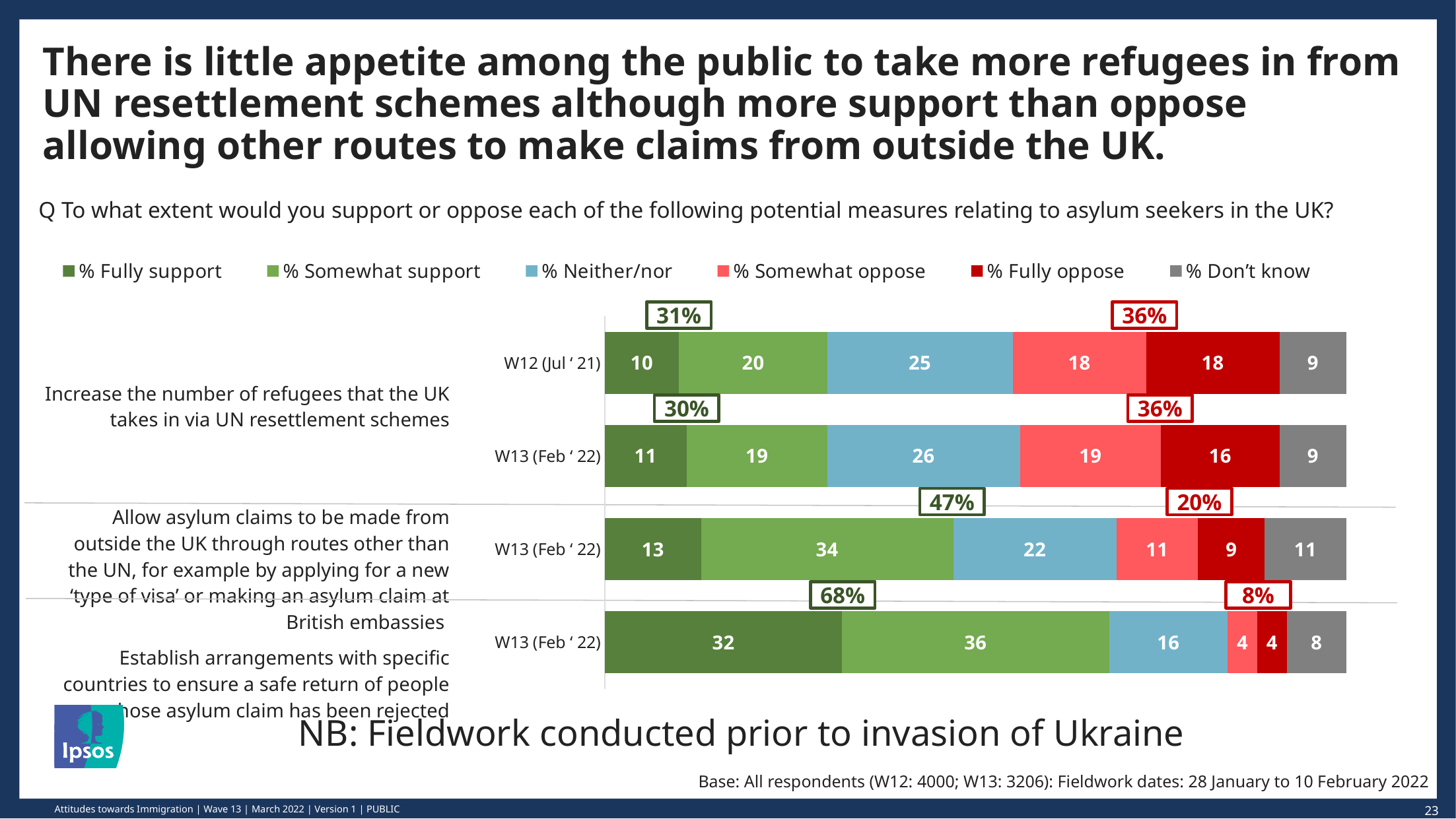
How many bars are plotted in the chart? 4 What kind of chart is shown on the slide? Stacked bar chart What is the % Neither/nor value for the W13 (Feb '22) bar on increasing the number of refugees the UK takes in via UN resettlement schemes? 26 What is the total of the stacked bar for establishing arrangements with specific countries to ensure a safe return of rejected asylum seekers? 100 What is the % Don't know value for allowing asylum claims to be made from outside the UK through routes other than the UN? 11 Which measure has the highest % Fully support value? Establish arrangements with specific countries to ensure a safe return of people whose asylum claim has been rejected What is the % Fully support value for establishing arrangements with specific countries to ensure a safe return of people whose asylum claim has been rejected? 32 How many series does the legend list? 6 What net support percentage is shown in the green box above the bar for allowing asylum claims to be made from outside the UK through routes other than the UN? 47% Which has the larger % Somewhat support value: allowing asylum claims from outside the UK through routes other than the UN, or establishing arrangements for a safe return of rejected asylum seekers? Establishing arrangements for a safe return of rejected asylum seekers For increasing the number of refugees via UN resettlement schemes, what is the difference in % Fully oppose between W12 (Jul '21) and W13 (Feb '22)? 2 Which bar has the lowest % Fully oppose value? Establish arrangements with specific countries to ensure a safe return (W13 Feb '22)